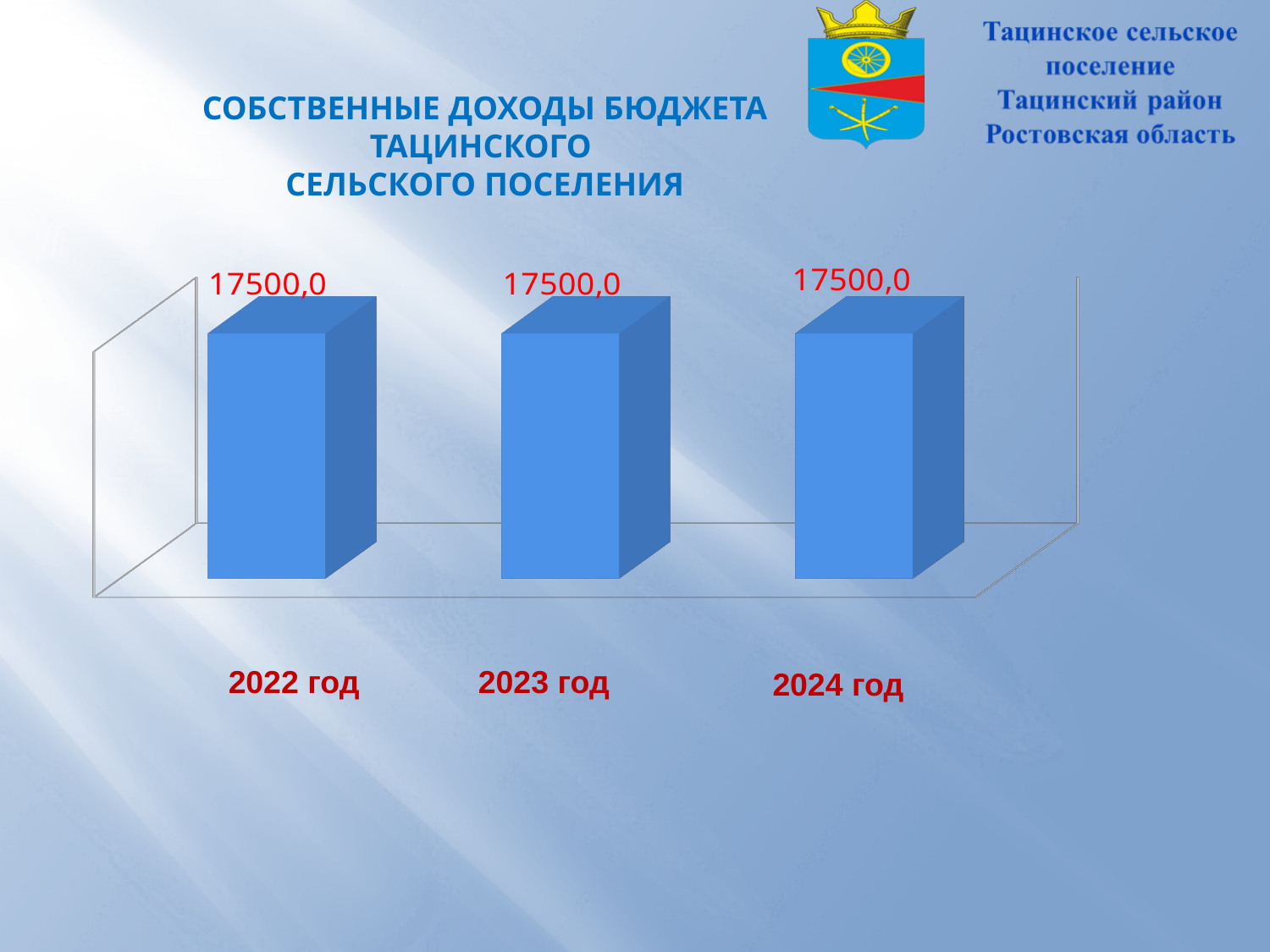
What is the title of the chart on the slide? СОБСТВЕННЫЕ ДОХОДЫ БЮДЖЕТА ТАЦИНСКОГО СЕЛЬСКОГО ПОСЕЛЕНИЯ What colour are the bars in the chart? blue What kind of chart is shown on the slide? bar chart What is the difference between the values for 2024 год and 2022 год? 0 What is the total of the values for 2022 год, 2023 год and 2024 год? 52500,0 What is the value shown for 2022 год? 17500,0 How many categories (years) are shown in the chart? 3 Do the values rise, fall, or stay the same from 2022 год to 2024 год? stay the same What is the value shown for 2023 год? 17500,0 What is the value shown for 2024 год? 17500,0